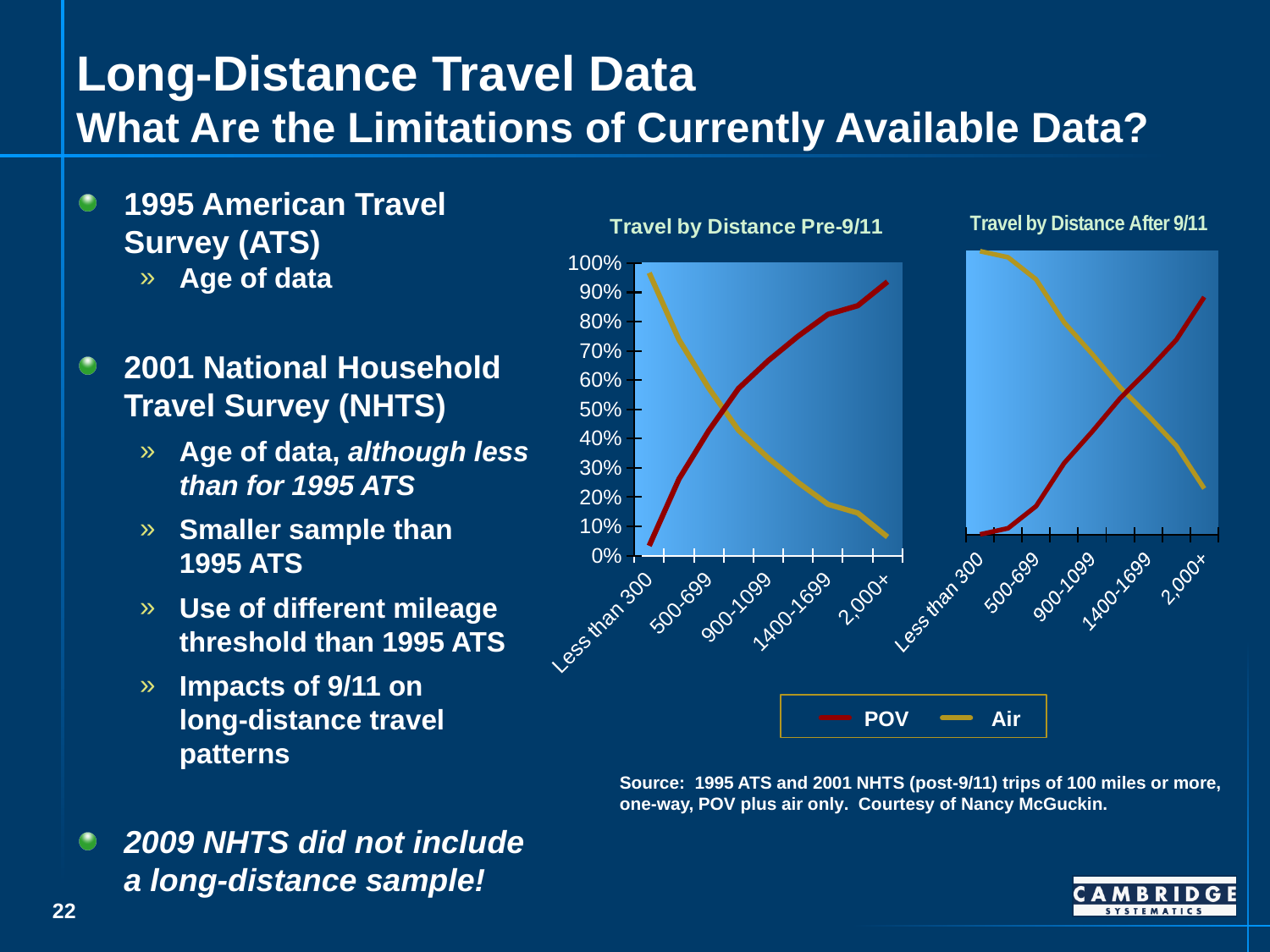
In the 'Travel by Distance After 9/11' chart, which series is higher at 'Less than 300', POV or Air? Air In the 'Travel by Distance Pre-9/11' chart, which series is higher at '1400-1699', POV or Air? POV What kind of chart is the 'Travel by Distance Pre-9/11' chart? line chart How many series does the legend list for the travel by distance charts? 2 In the 'Travel by Distance Pre-9/11' chart, does the Air line rise or fall as distance increases along the x axis? fall In the 'Travel by Distance Pre-9/11' chart, does the POV line rise or fall as distance increases along the x axis? rise In the 'Travel by Distance Pre-9/11' chart, is the POV value for '2,000+' greater or less than 80%? greater In the 'Travel by Distance Pre-9/11' chart, is the POV value for 'Less than 300' greater or less than 20%? less In the 'Travel by Distance Pre-9/11' chart, is the Air value for 'Less than 300' greater or less than 90%? greater Which two series are shown in the legend of the travel by distance charts? POV and Air In the 'Travel by Distance After 9/11' chart, does the POV line rise or fall as distance increases along the x axis? rise